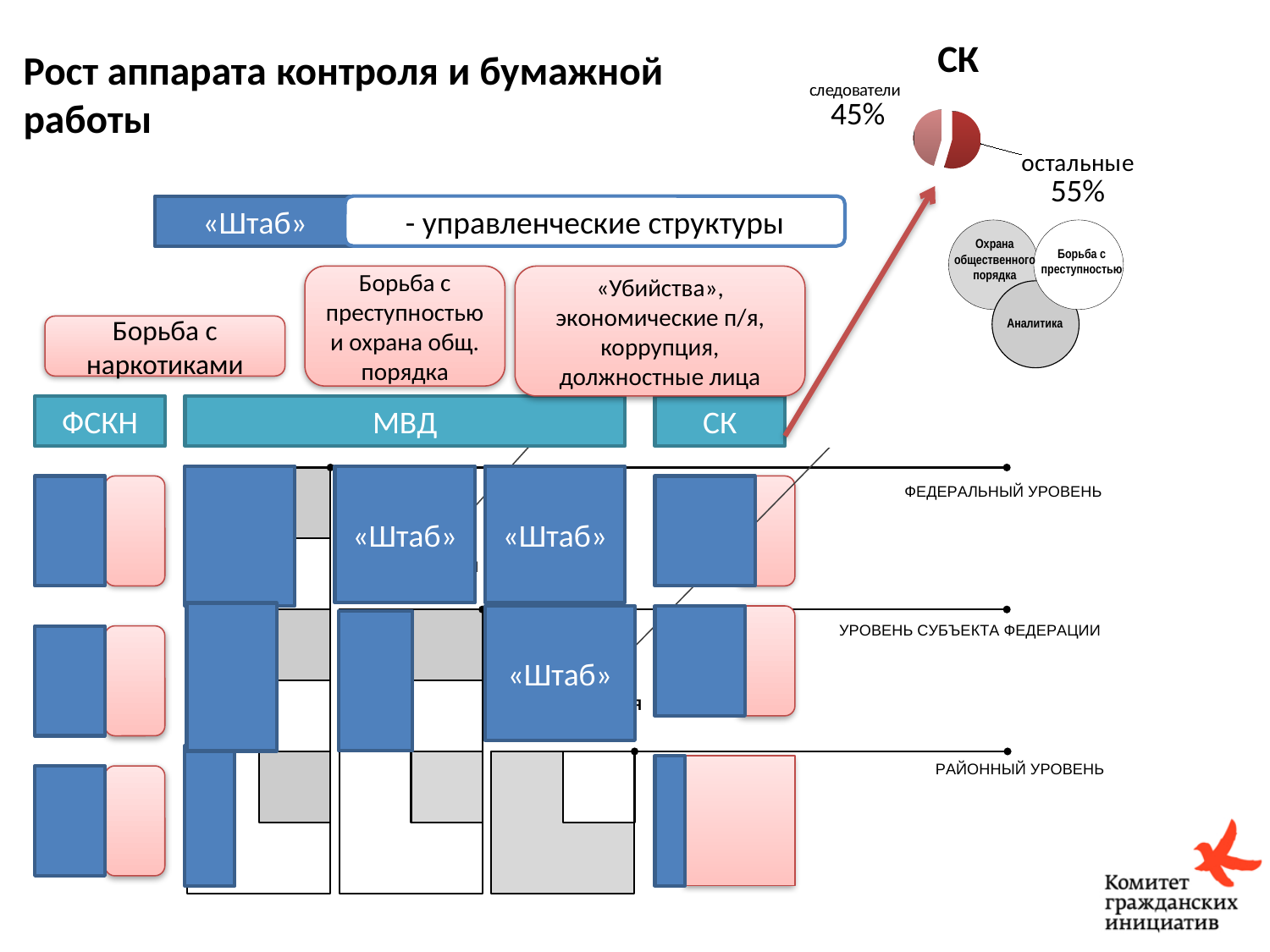
In the pie chart titled "СК", what share is labelled "остальные"? 55% In the pie chart titled "СК", how many slices are there? 2 What is the title of the pie chart in the top right of the slide? СК What kind of chart is the chart titled "СК" in the top right of the slide? pie chart In the pie chart titled "СК", which is larger: "следователи" or "остальные"? остальные In the pie chart titled "СК", what share is labelled "следователи"? 45% In the pie chart titled "СК", what is the difference in percentage points between "остальные" and "следователи"? 10 In the pie chart titled "СК", is the share for "следователи" greater or less than 50%? less In the pie chart titled "СК", which slice is the smallest? следователи In the pie chart titled "СК", which slice is the largest? остальные